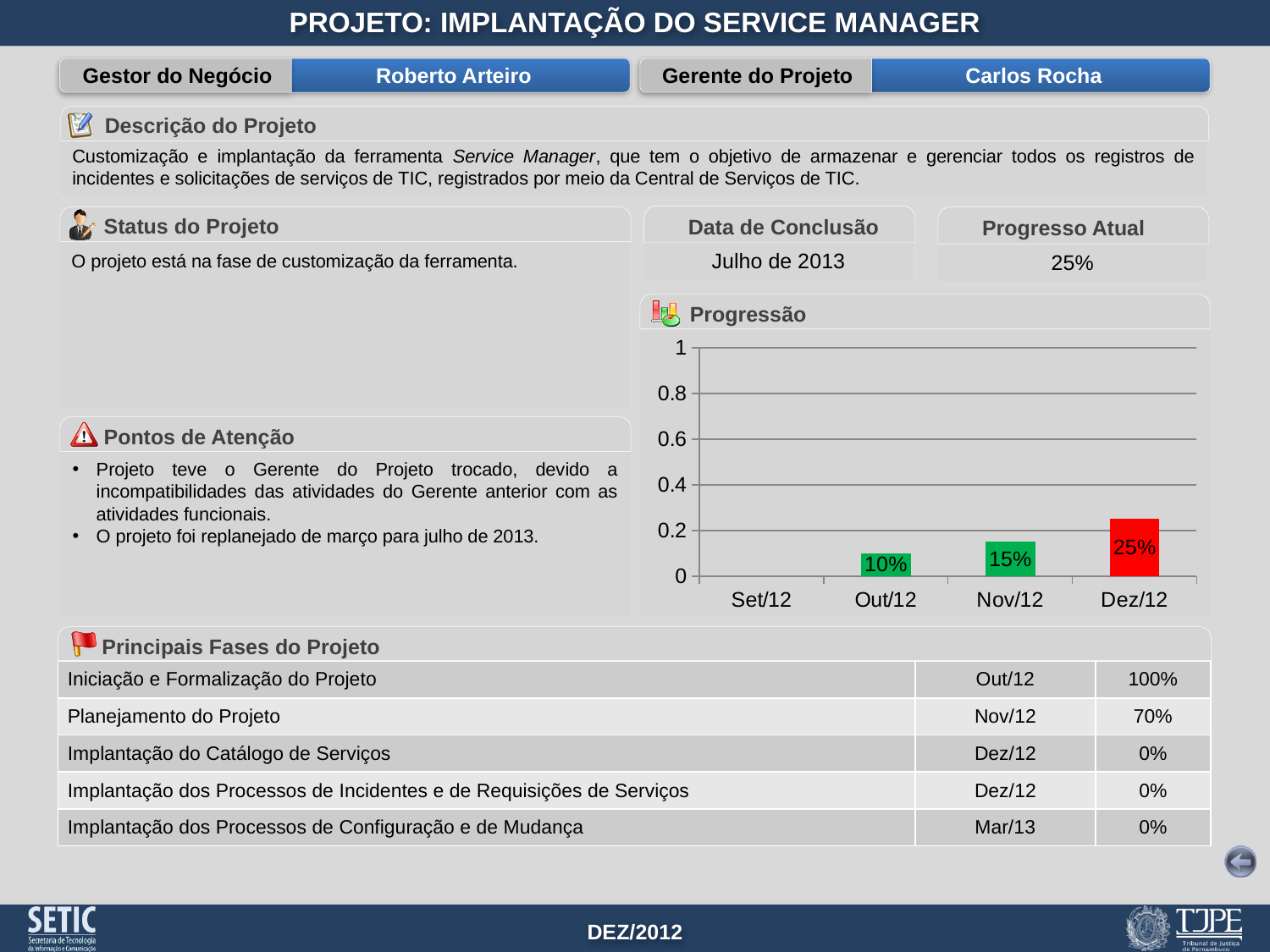
What kind of chart is the Progressão chart? bar chart Is the value for Dez/12 in the Progressão chart greater or less than 0.4? less What is the difference between the Nov/12 and Out/12 values in the Progressão chart? 5% Which month has the highest value in the Progressão chart? Dez/12 How many months are shown on the x axis of the Progressão chart? 4 What value is shown for Out/12 in the Progressão chart? 10% What value is shown for Dez/12 in the Progressão chart? 25% Do the values in the Progressão chart rise or fall from Out/12 to Dez/12? rise In the Progressão chart, which is larger: the value for Out/12 or the value for Dez/12? Dez/12 What is the difference between the Dez/12 and Nov/12 values in the Progressão chart? 10% What value is shown for Nov/12 in the Progressão chart? 15% Among the months with a labelled bar in the Progressão chart, which has the lowest value? Out/12